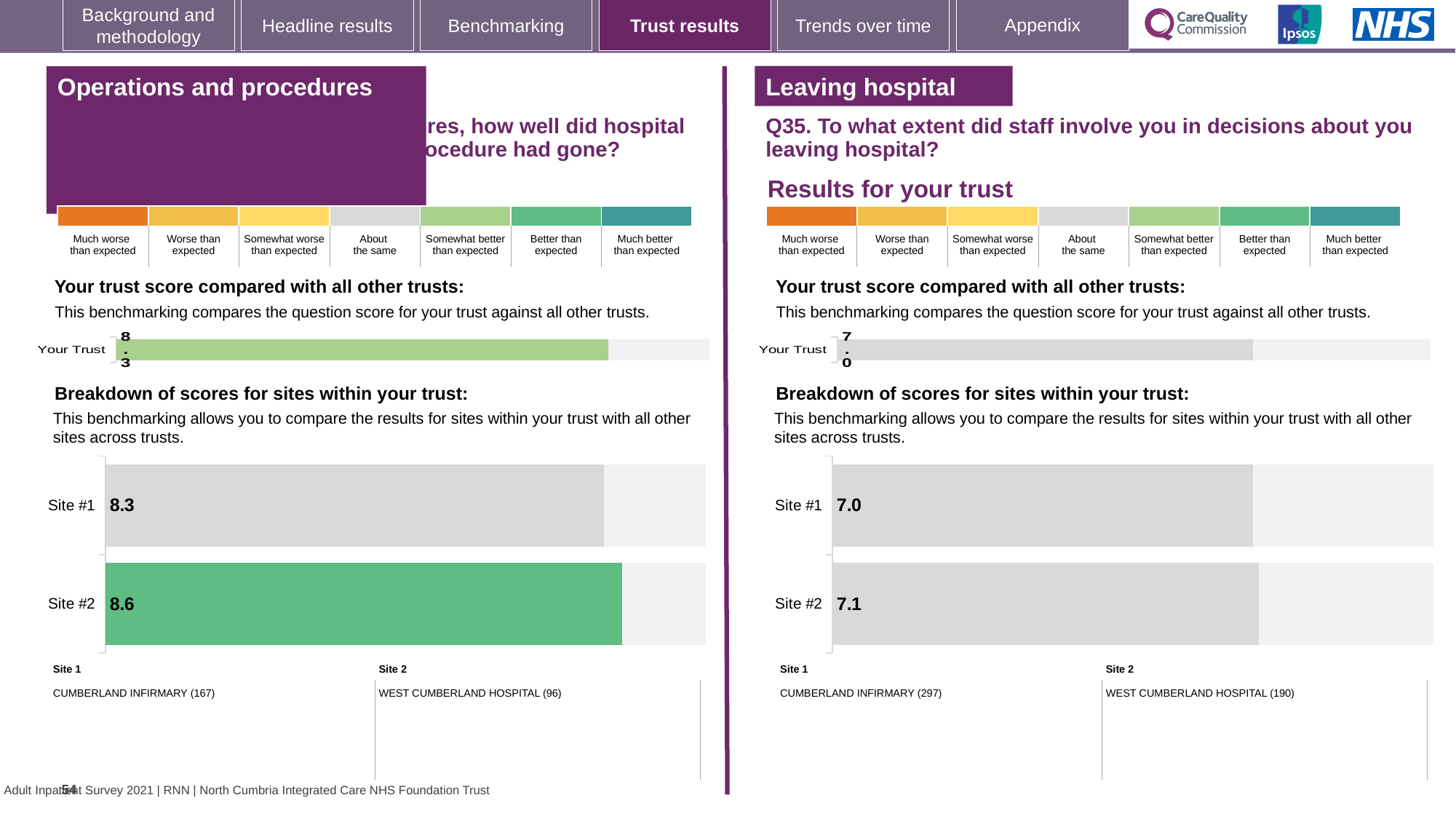
In the 'Operations and procedures' site breakdown chart, what is the score for Site #2? 8.6 How many sites are shown in the 'Leaving hospital' site breakdown chart? 2 In the 'Leaving hospital' site breakdown chart, what is the difference between the Site #2 and Site #1 scores? 0.1 In the 'Leaving hospital' 'Your Trust' chart, what is the trust score? 7.0 In the 'Leaving hospital' site breakdown chart, what is the score for Site #2? 7.1 What type of chart is used for the site breakdown under 'Operations and procedures'? Bar chart In the 'Operations and procedures' 'Your Trust' chart, what is the trust score? 8.3 In the 'Leaving hospital' site breakdown chart, what is the score for Site #1? 7.0 In the 'Operations and procedures' site breakdown chart, what is the difference between the Site #2 and Site #1 scores? 0.3 In the 'Operations and procedures' site breakdown chart, which site's bar is coloured green? Site #2 In the 'Operations and procedures' site breakdown chart, what is the score for Site #1? 8.3 In the 'Operations and procedures' site breakdown chart, which site has the higher score? Site #2